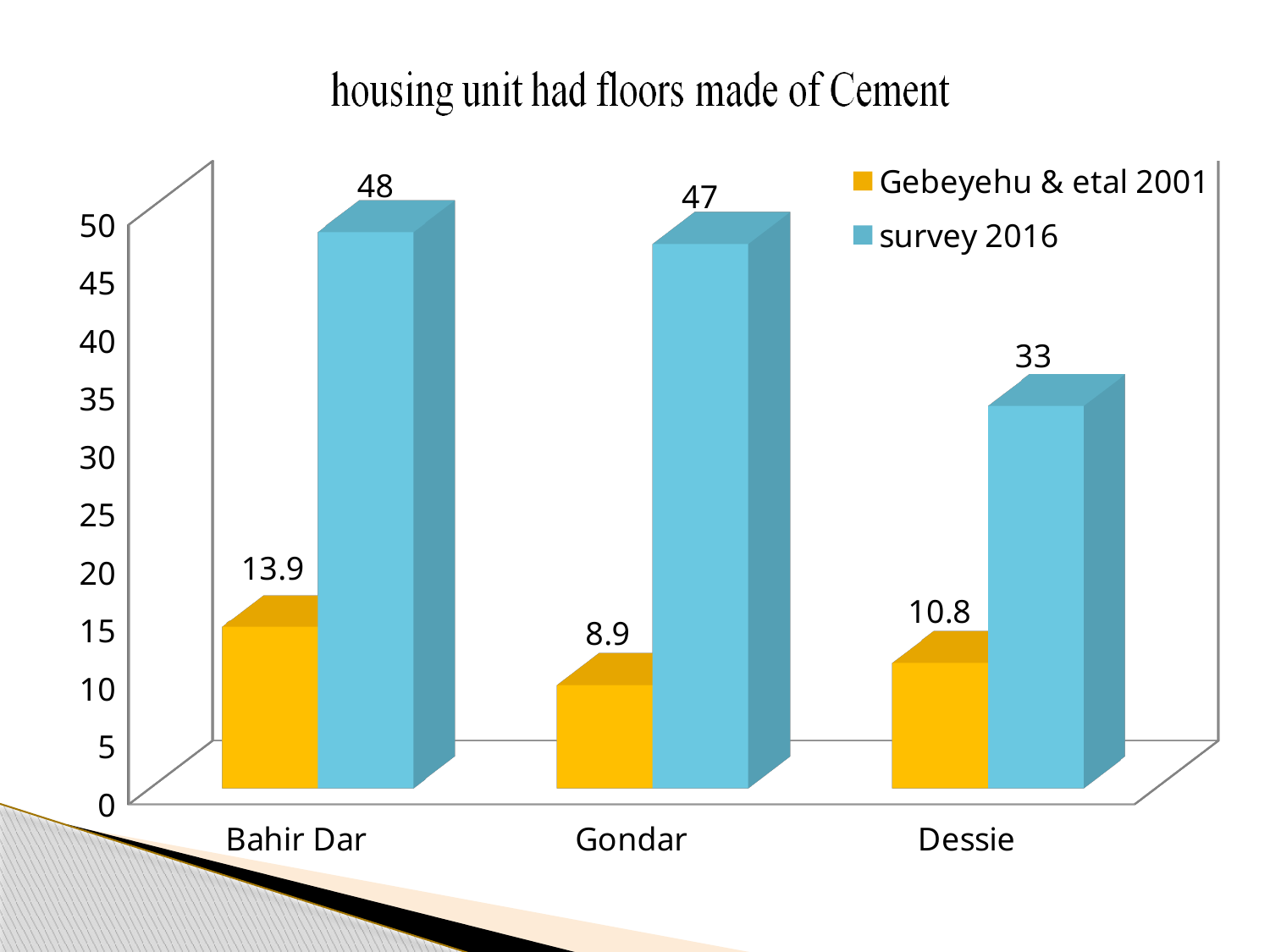
What is the survey 2016 value for Bahir Dar? 48 Which city has the highest Gebeyehu & etal 2001 value? Bahir Dar How many series does the legend list? 2 What is the difference between the survey 2016 value and the Gebeyehu & etal 2001 value for Bahir Dar? 34.1 What is the Gebeyehu & etal 2001 value for Dessie? 10.8 What kind of chart is shown on the slide? bar chart How many cities are shown on the x axis? 3 Which city has the lowest survey 2016 value? Dessie Which is larger for Gondar: the survey 2016 value or the Gebeyehu & etal 2001 value? survey 2016 What is the title of the chart? housing unit had floors made of Cement What is the Gebeyehu & etal 2001 value for Gondar? 8.9 What is the survey 2016 value for Dessie? 33